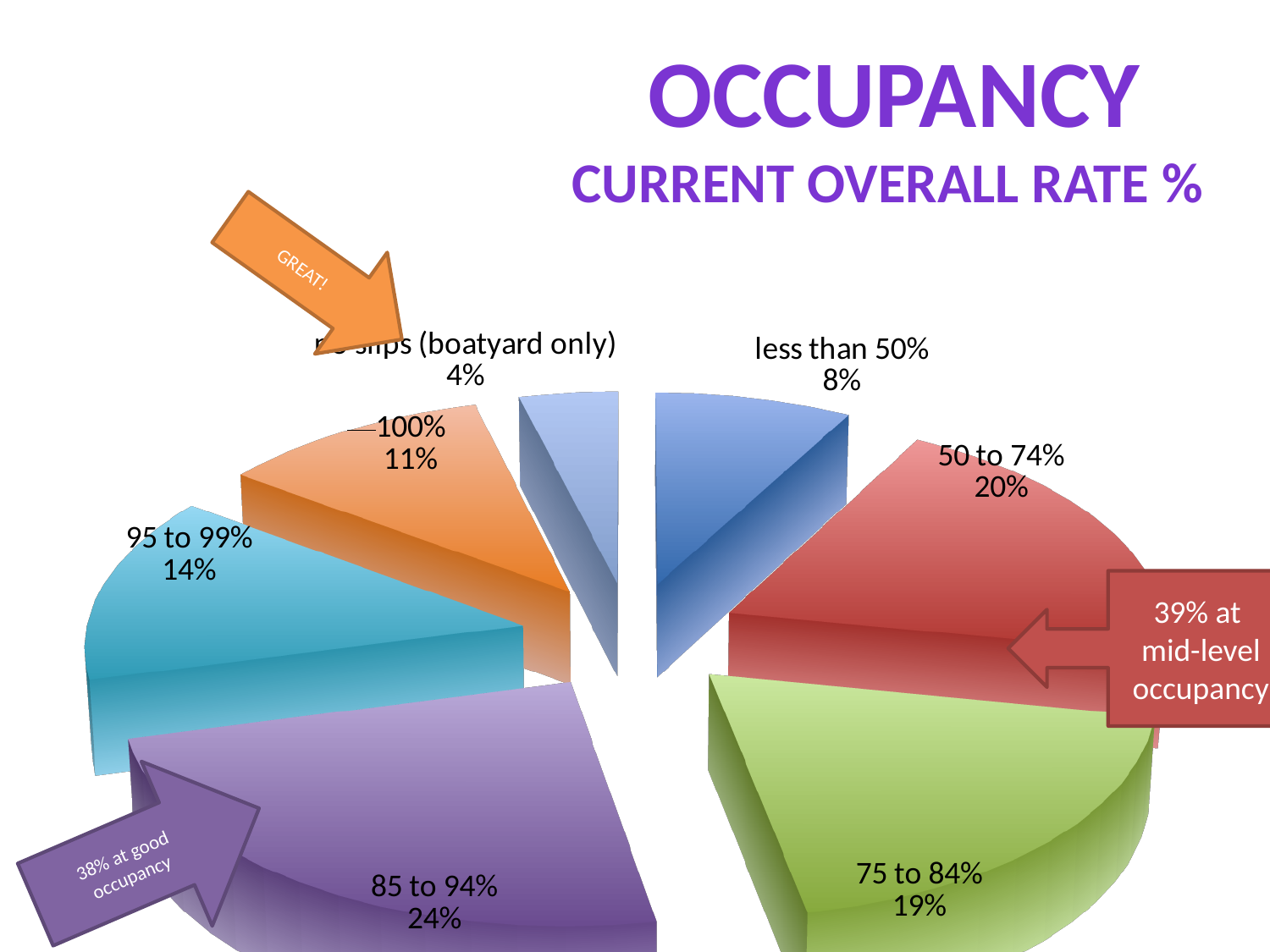
What share of the pie is the "100%" slice? 11% What is the difference in percentage points between the "85 to 94%" slice and the "95 to 99%" slice? 10 Which category has the largest slice of the pie? 85 to 94% What share of the pie is the "50 to 74%" slice? 20% What kind of chart is shown on the slide? pie chart What share of the pie is the "85 to 94%" slice? 24% How many slices does the pie chart have? 7 What share of the pie is the "less than 50%" slice? 8% Which slice is larger, "50 to 74%" or "75 to 84%"? 50 to 74% What is the subtitle shown under the word OCCUPANCY on the slide? CURRENT OVERALL RATE % What share of the pie is the "95 to 99%" slice? 14% Which category has the smallest slice of the pie? no slips (boatyard only)